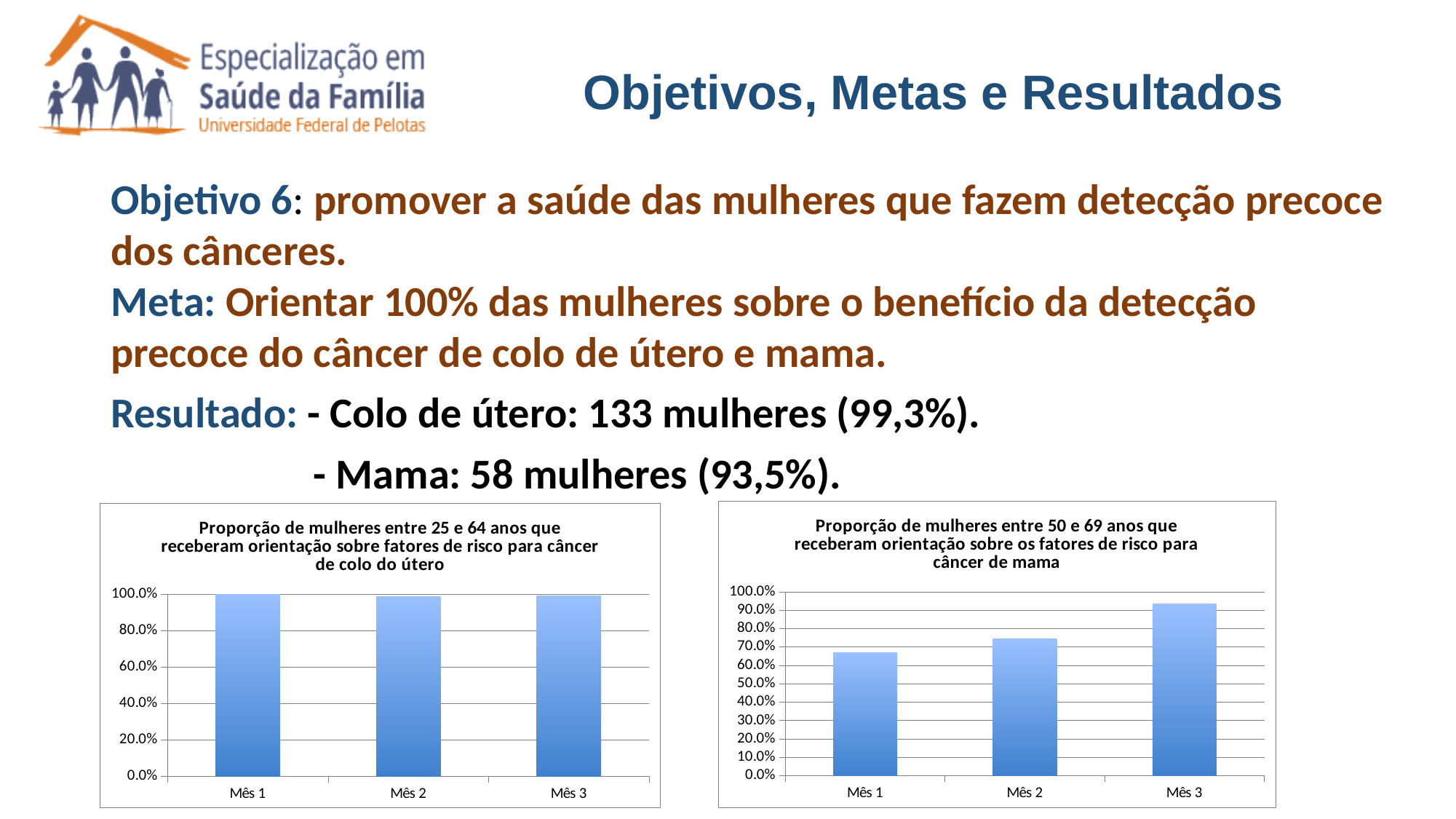
In the chart on the right (Proporção de mulheres entre 50 e 69 anos), do the values rise or fall from Mês 1 to Mês 3? rise In the chart on the right (Proporção de mulheres entre 50 e 69 anos), which month has the highest value? Mês 3 In the chart on the right (Proporção de mulheres entre 50 e 69 anos), is the value for Mês 2 greater or less than 70.0%? greater In the chart on the right (Proporção de mulheres entre 50 e 69 anos), which is larger, the value for Mês 2 or Mês 3? Mês 3 In the chart on the left (Proporção de mulheres entre 25 e 64 anos), is the value for Mês 2 greater or less than 80.0%? greater How many bars are plotted in the chart on the right (Proporção de mulheres entre 50 e 69 anos)? 3 What is the highest tick value shown on the y axis of the chart on the right (Proporção de mulheres entre 50 e 69 anos)? 100.0% What kind of chart is the chart on the left (Proporção de mulheres entre 25 e 64 anos)? bar chart In the chart on the right (Proporção de mulheres entre 50 e 69 anos), is the value for Mês 3 greater or less than 90.0%? greater How many months are shown on the x axis of the chart on the left (Proporção de mulheres entre 25 e 64 anos)? 3 In the chart on the right (Proporção de mulheres entre 50 e 69 anos), which month has the lowest value? Mês 1